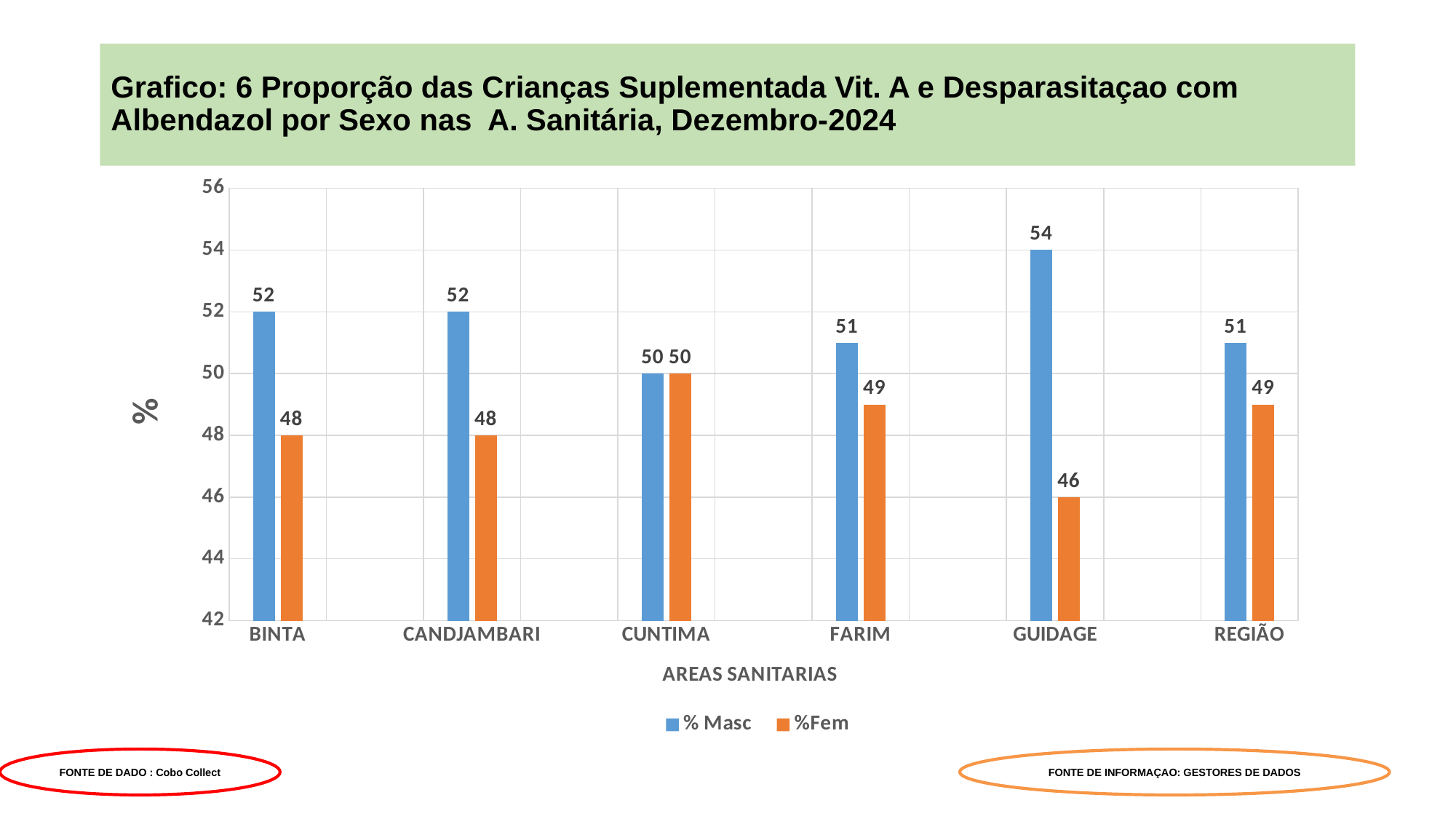
Which area has the highest % Masc value? GUIDAGE What is the % Masc value for GUIDAGE? 54 Which area has the lowest %Fem value? GUIDAGE How many series does the legend list? 2 What is the %Fem value for CUNTIMA? 50 How many areas (categories) are shown on the x axis? 6 What kind of chart is shown on the slide? bar chart What is the %Fem value for FARIM? 49 Which is larger for BINTA, the % Masc value or the %Fem value? % Masc Is the %Fem value for CANDJAMBARI greater or less than 50? less What is the label of the x axis? AREAS SANITARIAS What is the difference between the % Masc and %Fem values for GUIDAGE? 8